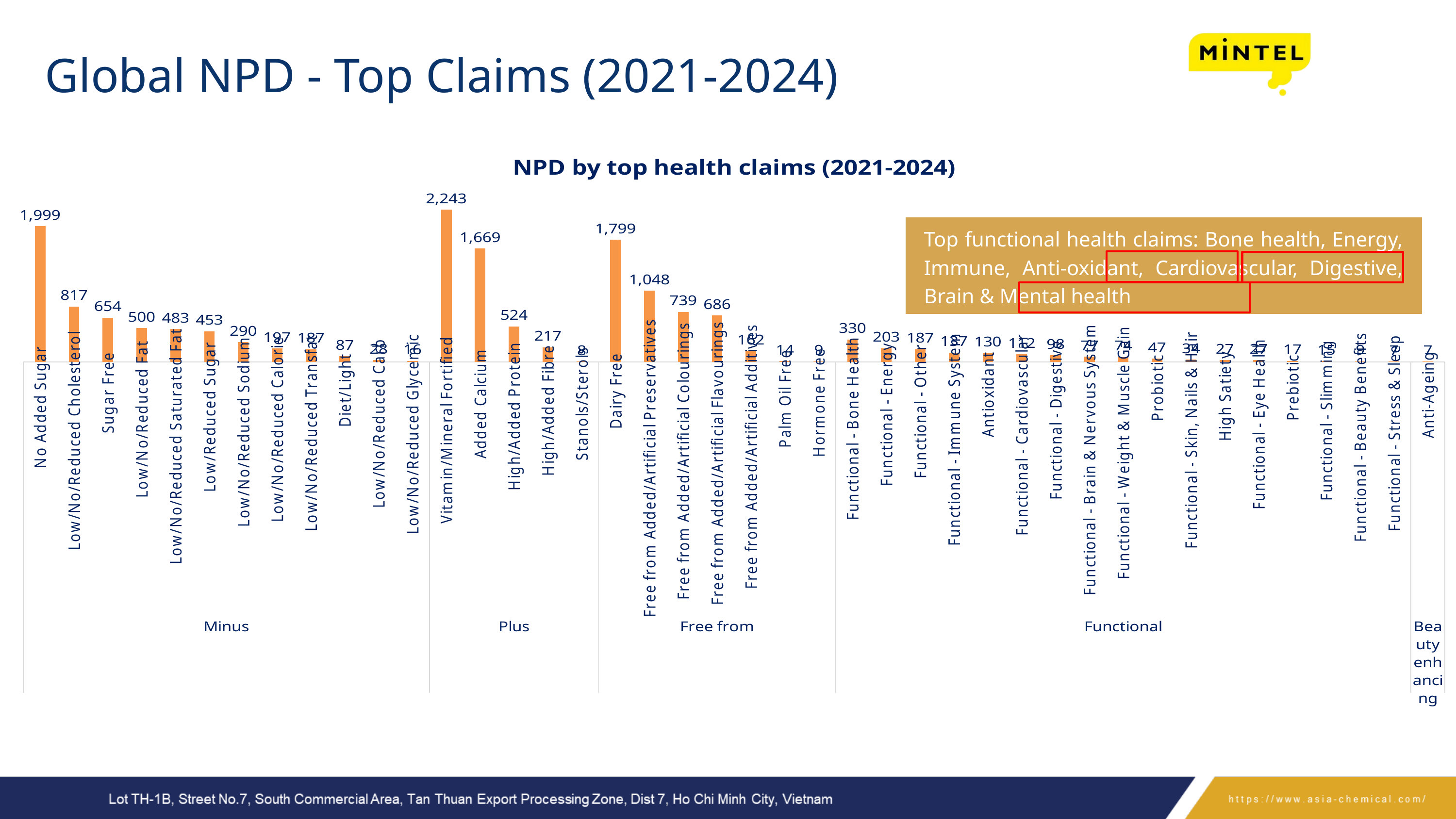
What is the difference between the values for Dairy Free and Added Calcium? 130 What is the value for No Added Sugar? 1,999 Which has a larger value, Sugar Free or Low/No/Reduced Fat? Sugar Free Which claim has the highest value in the chart? Vitamin/Mineral Fortified What is the value for Probiotic? 47 What is the value for Functional - Bone Health? 330 What kind of chart is shown on the slide? Bar chart What is the value for Vitamin/Mineral Fortified? 2,243 What is the difference between the values for Vitamin/Mineral Fortified and No Added Sugar? 244 How many claims are shown in the Plus group? 5 What is the title of the chart? NPD by top health claims (2021-2024) What is the value for Free from Added/Artificial Preservatives? 1,048